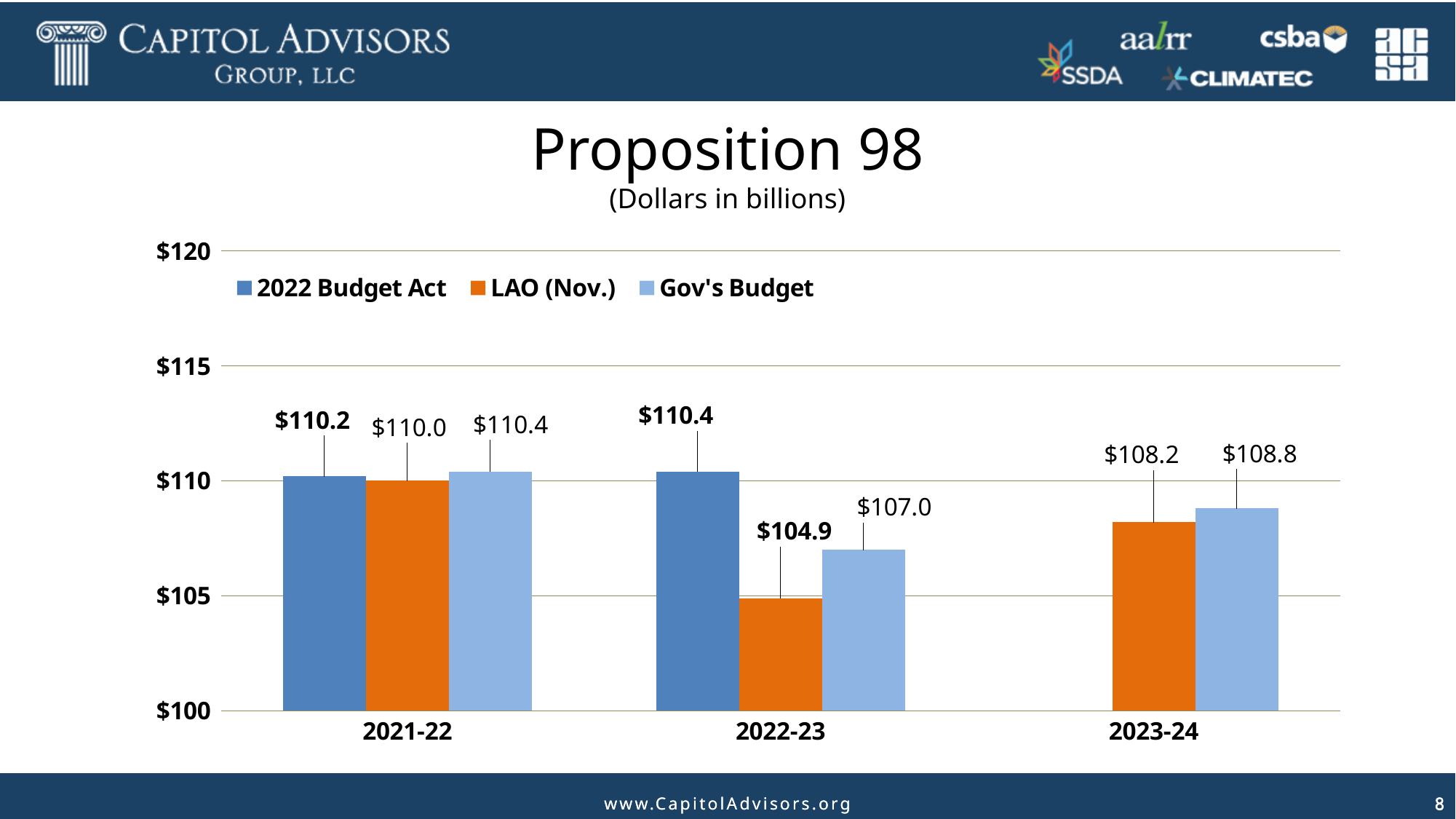
Which series has the lowest value in 2022-23? LAO (Nov.) Which series has the highest value in 2022-23? 2022 Budget Act What is the Gov's Budget value for 2023-24? $108.8 What is the 2022 Budget Act value for 2021-22? $110.2 What is the LAO (Nov.) value for 2022-23? $104.9 How many series does the legend list? 3 How many fiscal year categories are shown on the x axis? 3 What is the Gov's Budget value for 2022-23? $107.0 What is the difference between the 2022 Budget Act and LAO (Nov.) values for 2022-23? $5.5 Which is larger for 2022-23: the Gov's Budget value or the LAO (Nov.) value? Gov's Budget What kind of chart is shown on the slide? Bar chart What is the difference between the Gov's Budget and LAO (Nov.) values for 2023-24? $0.6